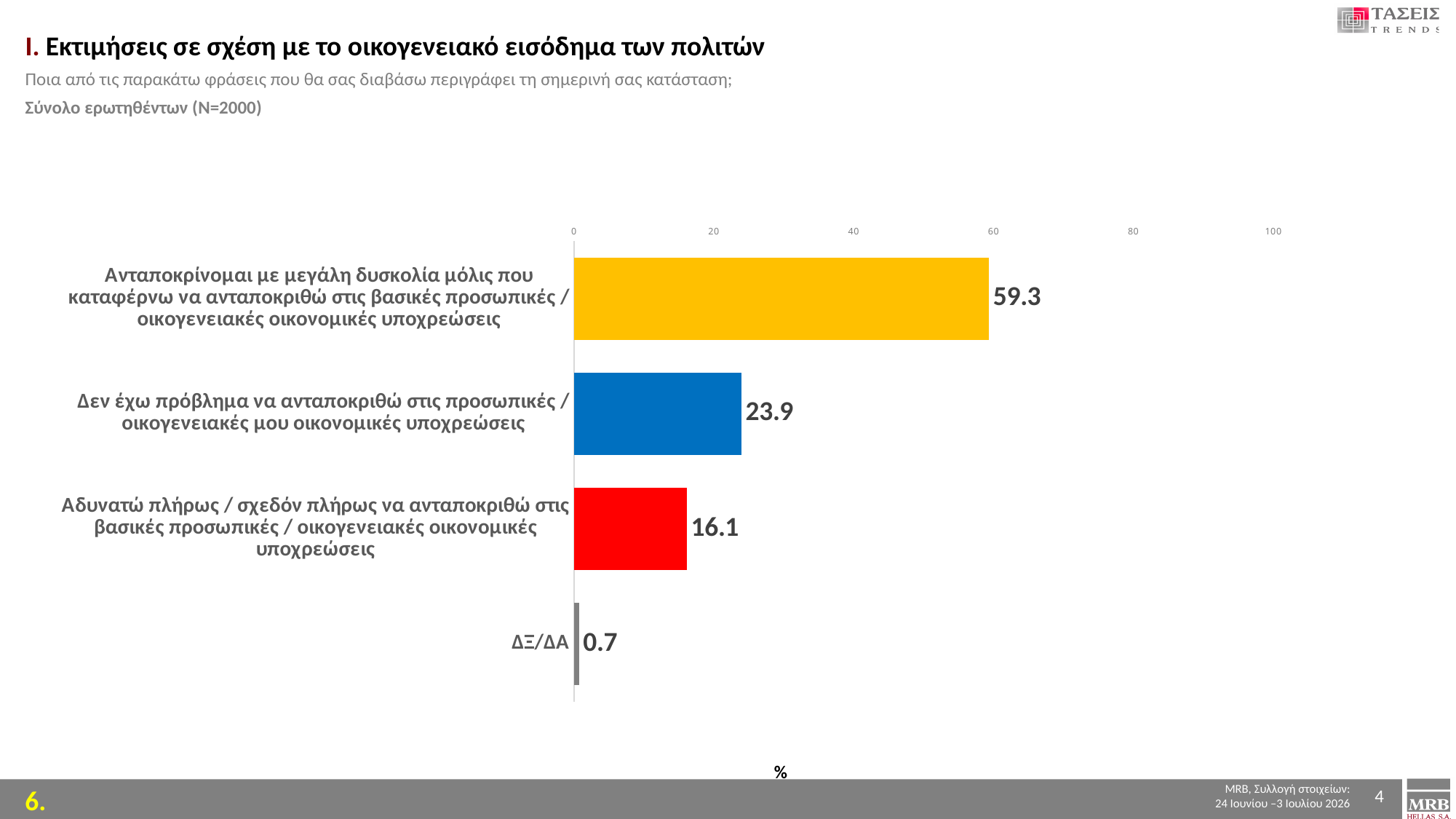
What is the value for the category "Αδυνατώ πλήρως / σχεδόν πλήρως να ανταποκριθώ στις βασικές προσωπικές / οικογενειακές οικονομικές υποχρεώσεις"? 16.1 Which category has the highest value? Ανταποκρίνομαι με μεγάλη δυσκολία μόλις που καταφέρνω να ανταποκριθώ στις βασικές προσωπικές / οικογενειακές οικονομικές υποχρεώσεις Which category has the lowest value? ΔΞ/ΔΑ What colour is the bar for "Αδυνατώ πλήρως / σχεδόν πλήρως να ανταποκριθώ..."? red What kind of chart is shown on the slide? bar chart Which is larger: the value for "Ανταποκρίνομαι με μεγάλη δυσκολία..." or the value for "Δεν έχω πρόβλημα να ανταποκριθώ..."? Ανταποκρίνομαι με μεγάλη δυσκολία... What is the difference between the value for "Δεν έχω πρόβλημα να ανταποκριθώ..." (23.9) and the value for "Αδυνατώ πλήρως / σχεδόν πλήρως να ανταποκριθώ..." (16.1)? 7.8 What is the value for the category "Ανταποκρίνομαι με μεγάλη δυσκολία μόλις που καταφέρνω να ανταποκριθώ στις βασικές προσωπικές / οικογενειακές οικονομικές υποχρεώσεις"? 59.3 What is the value for ΔΞ/ΔΑ? 0.7 What is the value for the category "Δεν έχω πρόβλημα να ανταποκριθώ στις προσωπικές / οικογενειακές μου οικονομικές υποχρεώσεις"? 23.9 Is the value for "Αδυνατώ πλήρως / σχεδόν πλήρως να ανταποκριθώ..." greater or less than 20? less How many categories are shown in the chart? 4